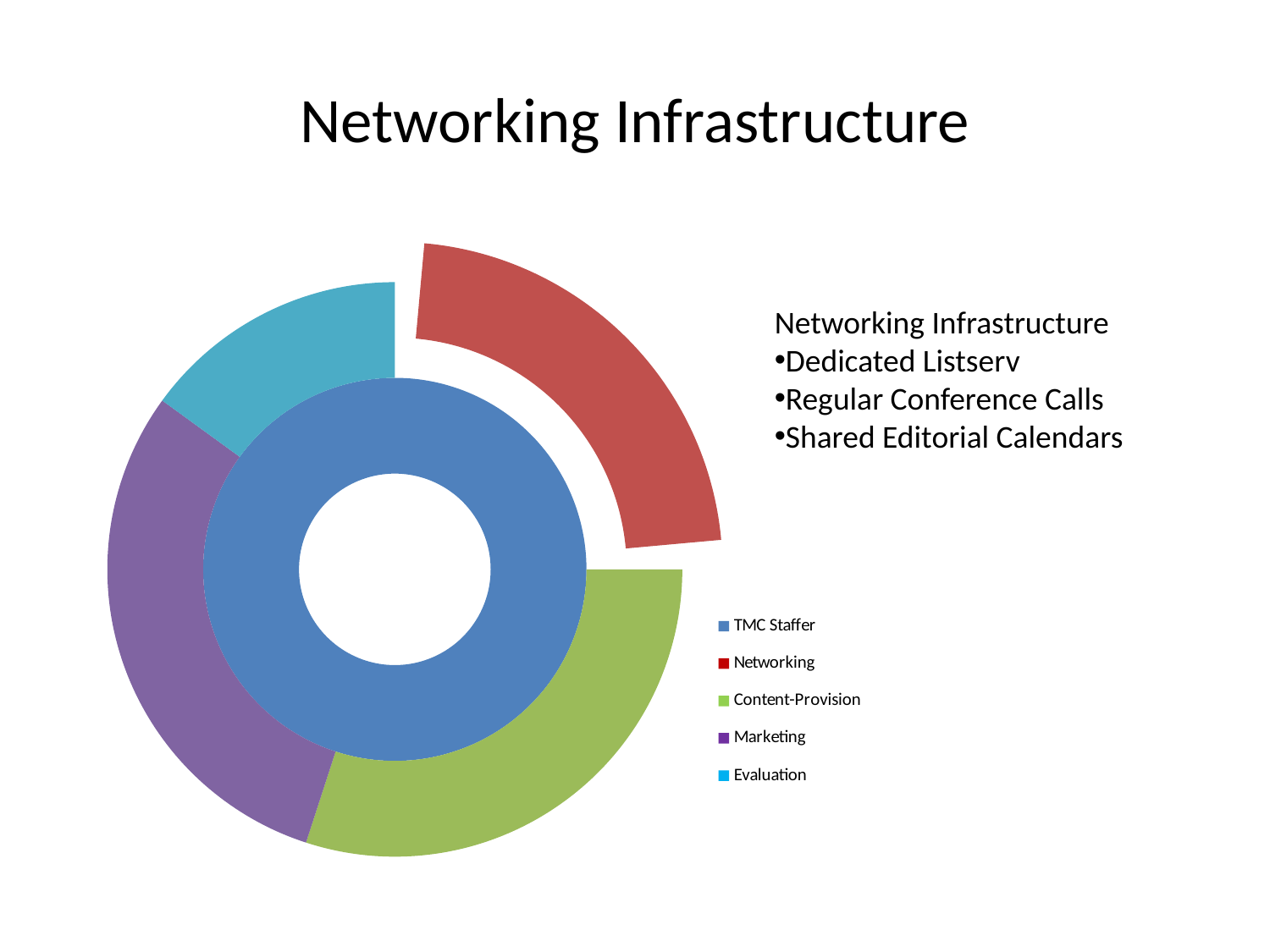
What kind of chart is shown on the slide? Doughnut chart Which slice of the outer ring is pulled out (exploded) from the rest of the chart? Networking Which legend entry is shown in the inner ring of the doughnut chart? TMC Staffer How many entries does the chart legend list? 5 Which slice is larger in the outer ring: Marketing or Evaluation? Marketing Which slice is larger in the outer ring: Networking or Evaluation? Networking Which slice is larger in the outer ring: Content-Provision or Evaluation? Content-Provision Which category has the smallest slice in the outer ring of the chart? Evaluation What is the title of the slide containing the chart? Networking Infrastructure